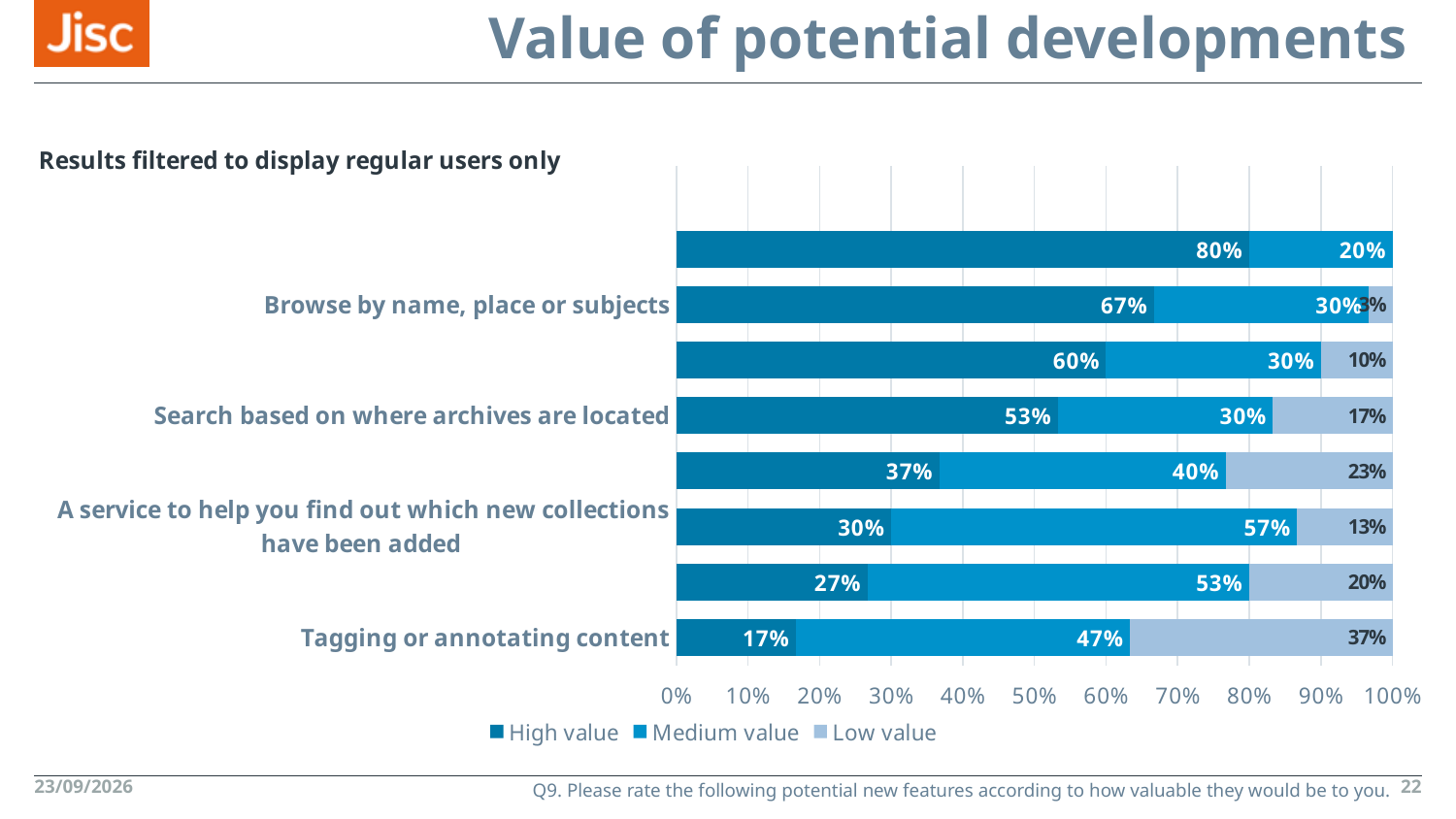
What do the three segments of 'Search based on where archives are located' add up to? 100% What type of chart is shown on the slide? Stacked bar chart Which category has the highest Low value percentage? Tagging or annotating content For 'Tagging or annotating content', how many percentage points higher is the Medium value share than the High value share? 30 percentage points Which category has the lowest High value percentage? Tagging or annotating content How many series does the legend list? 3 What is the Low value percentage for 'Search based on where archives are located'? 17% What is the Medium value percentage for 'A service to help you find out which new collections have been added'? 57% How many bars are plotted in the chart? 8 What percentage of regular users rated 'Tagging or annotating content' as High value? 17% Which has a larger High value share: 'Search based on where archives are located' or 'A service to help you find out which new collections have been added'? Search based on where archives are located What is the High value percentage for 'Browse by name, place or subjects'? 67%